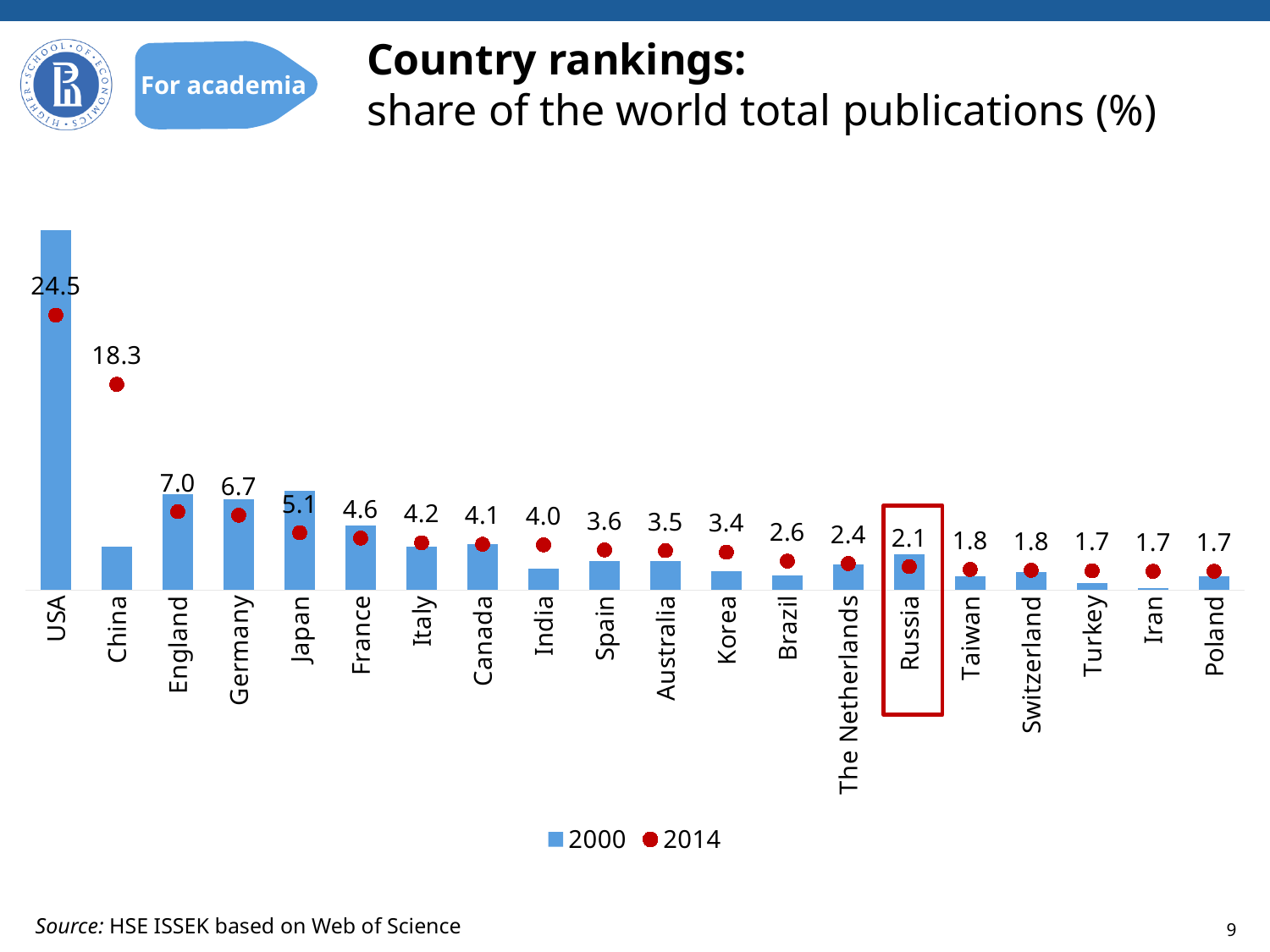
Do the 2014 values rise or fall from left to right along the x axis? fall What is the difference between the 2014 values for England and Germany? 0.3 What is the 2014 value shown for The Netherlands? 2.4 What is the 2014 value shown for Russia? 2.1 What is the difference between the 2014 values for the USA and China? 6.2 For China, which is larger: the 2000 bar or the 2014 dot? 2014 What is the 2014 share of world total publications for the USA? 24.5 Which country has the highest 2014 share of world total publications? USA Which country has the taller 2000 bar, the USA or China? USA What is the 2014 value shown for China? 18.3 How many countries are shown on the chart? 20 How many series does the legend list? 2